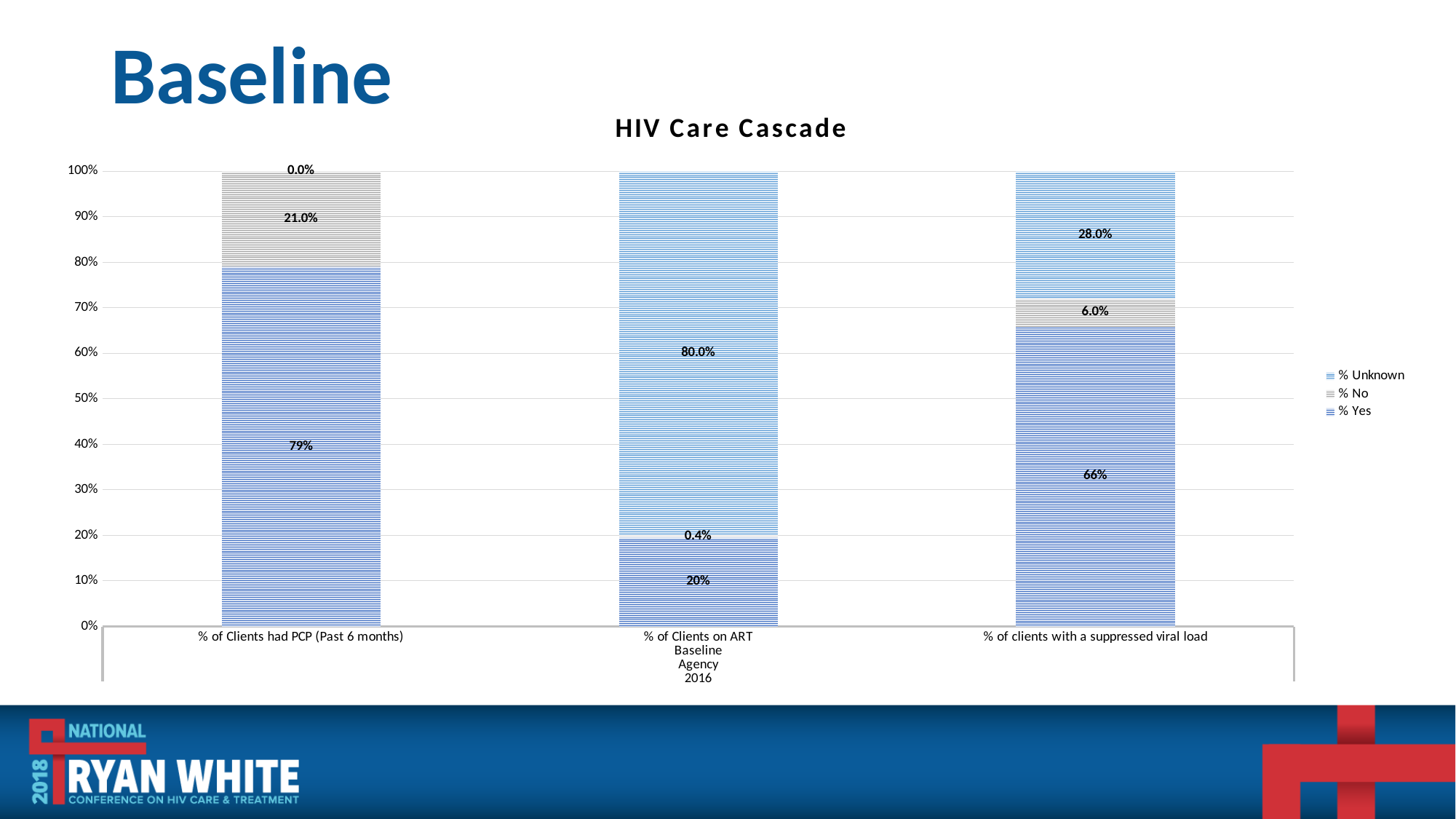
What is the % Unknown value for "% of Clients on ART"? 80.0% Which category has the highest % Yes value? % of Clients had PCP (Past 6 months) How many categories are shown on the x axis of the chart? 3 What is the difference between the % Yes value for "% of Clients had PCP (Past 6 months)" and the % Yes value for "% of clients with a suppressed viral load"? 13% How many series does the legend list? 3 Which category has the lowest % Yes value? % of Clients on ART What is the % No value for "% of Clients had PCP (Past 6 months)"? 21.0% What is the % No value for "% of clients with a suppressed viral load"? 6.0% What is the % Unknown value for "% of clients with a suppressed viral load"? 28.0% What is the % Yes value for "% of Clients had PCP (Past 6 months)"? 79% Which has the larger % Unknown value: "% of Clients on ART" or "% of clients with a suppressed viral load"? % of Clients on ART What type of chart is shown on the slide? Stacked bar chart